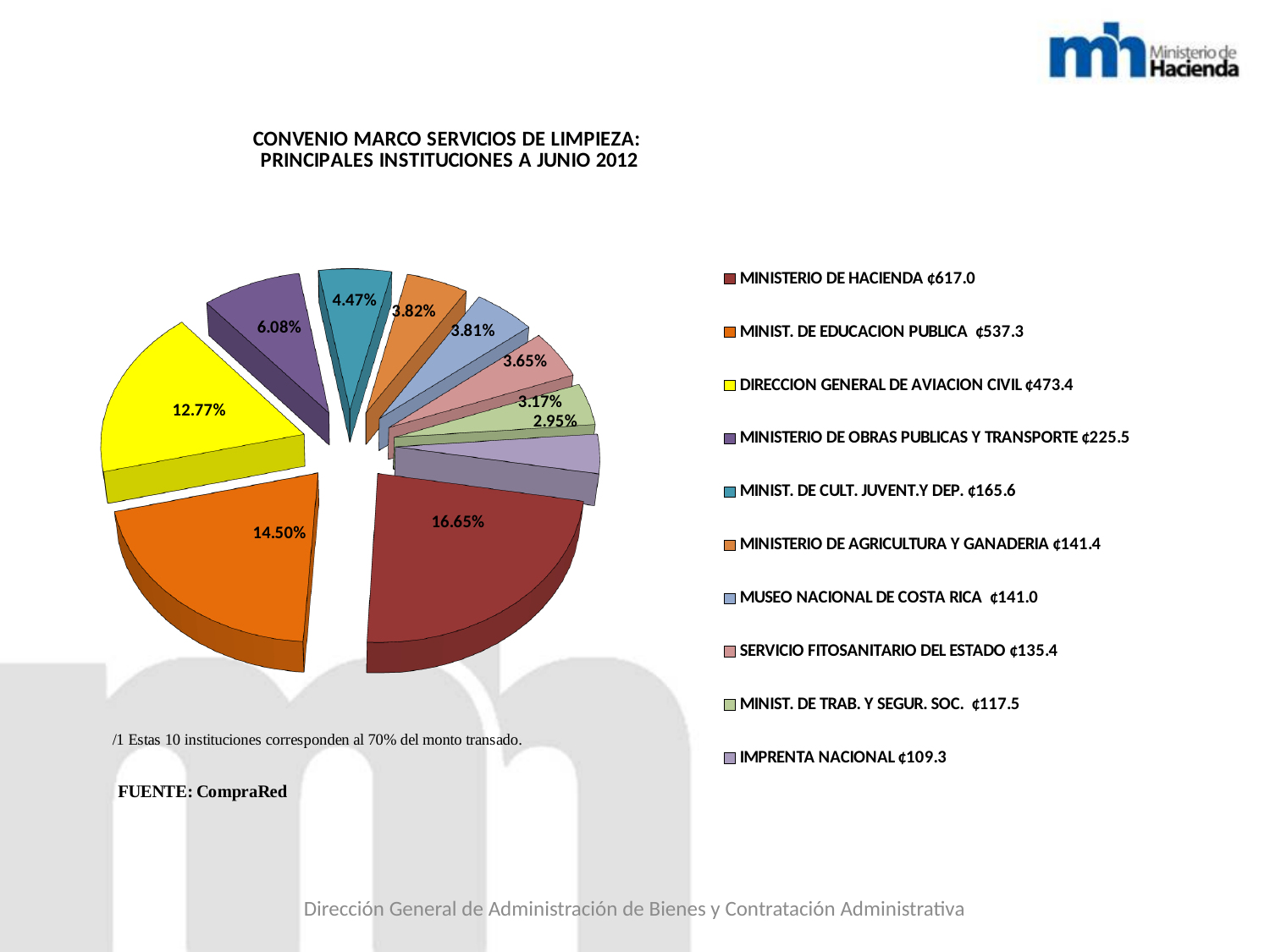
What amount does the legend show for IMPRENTA NACIONAL? ¢109.3 What percentage is shown for DIRECCION GENERAL DE AVIACION CIVIL? 12.77% What is the title of the chart? CONVENIO MARCO SERVICIOS DE LIMPIEZA: PRINCIPALES INSTITUCIONES A JUNIO 2012 What amount does the legend show for MINIST. DE EDUCACION PUBLICA? ¢537.3 Which institution has the smallest slice of the pie? IMPRENTA NACIONAL Which has a larger share: MINISTERIO DE OBRAS PUBLICAS Y TRANSPORTE or MINIST. DE CULT. JUVENT.Y DEP.? MINISTERIO DE OBRAS PUBLICAS Y TRANSPORTE What kind of chart is shown on the slide? Pie chart What percentage is shown for MINIST. DE TRAB. Y SEGUR. SOC.? 3.17% How many institutions are shown in the pie chart? 10 What is the difference between the amounts for MINISTERIO DE HACIENDA and MINIST. DE EDUCACION PUBLICA? ¢79.7 What percentage share of the pie does MINISTERIO DE HACIENDA hold? 16.65% Which institution has the largest slice of the pie? MINISTERIO DE HACIENDA